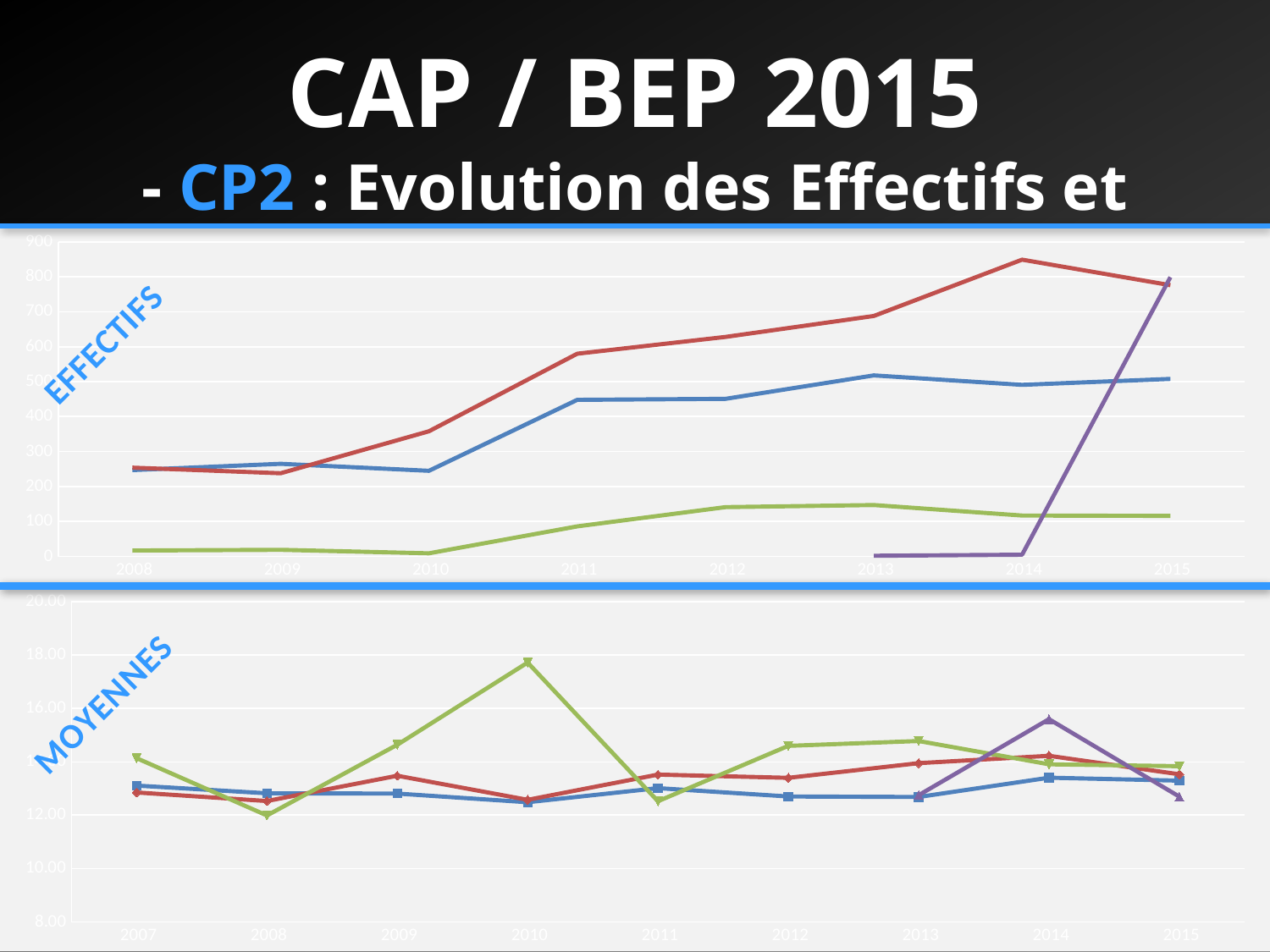
How many years are shown on the x axis of the top chart (EFFECTIFS)? 8 What kind of chart is the bottom chart labelled MOYENNES? line chart What is the label written beside the bottom chart? MOYENNES In the top chart (EFFECTIFS), is the value of the purple line in 2015 greater or less than 700? greater In the bottom chart (MOYENNES), is the value of the purple line in 2014 greater or less than 14.00? greater In the top chart (EFFECTIFS), is the value of the green line in 2010 greater or less than 100? less What kind of chart is the top chart labelled EFFECTIFS? line chart In the top chart (EFFECTIFS), does the red line generally rise or fall from 2008 to 2014? rise How many years are shown on the x axis of the bottom chart (MOYENNES)? 9